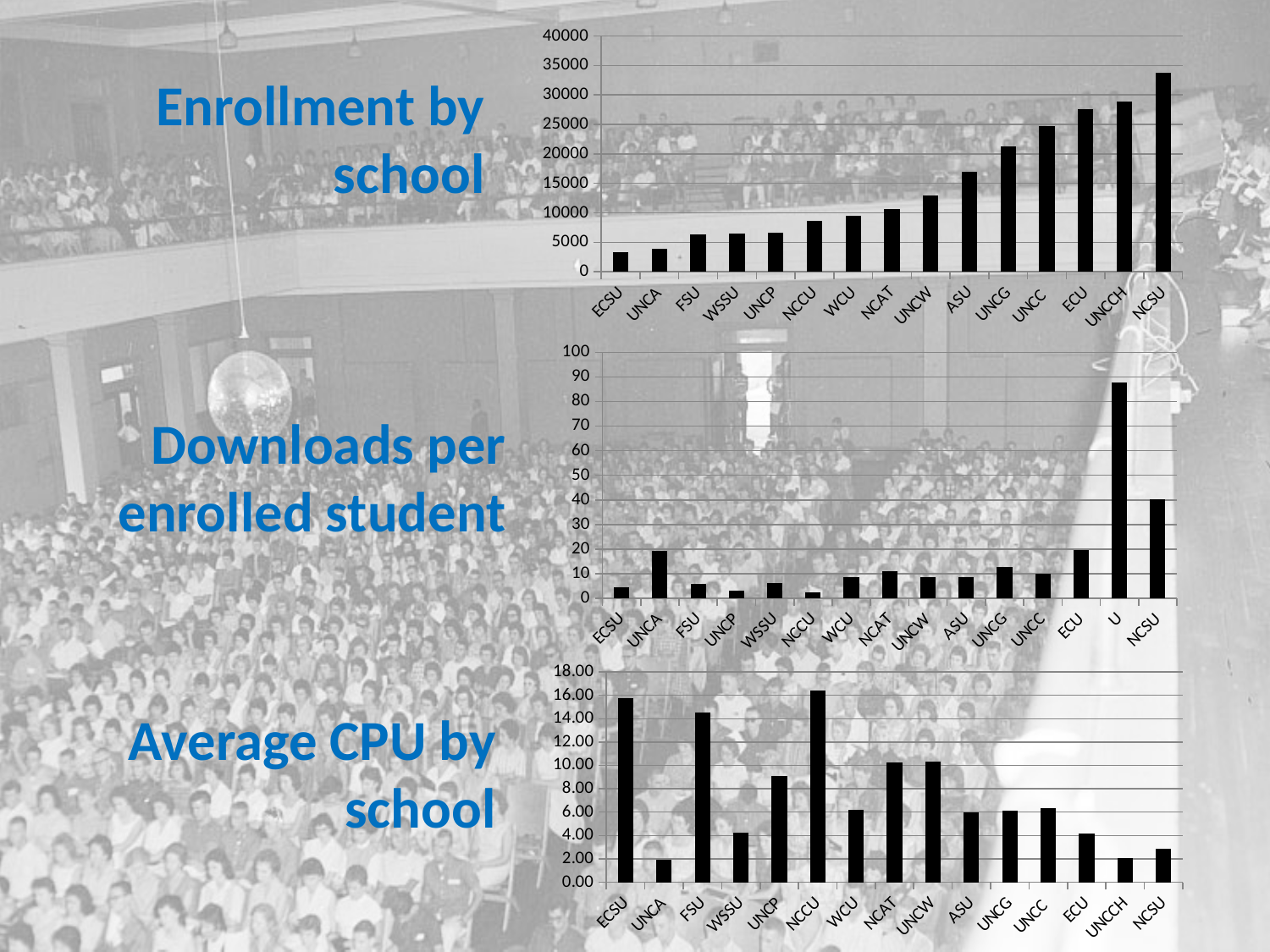
On the "Average CPU by school" chart, is the value for UNCA greater or less than 4.00? less On the "Enrollment by school" chart, is the value for NCSU greater or less than 30000? greater On the "Enrollment by school" chart, which school has the highest enrollment? NCSU On the "Downloads per enrolled student" chart, which has the larger value, UNCA or FSU? UNCA On the "Downloads per enrolled student" chart, which school has the highest value? U On the "Enrollment by school" chart, which school has the lowest enrollment? ECSU On the "Enrollment by school" chart, which has the larger value, ECU or UNCG? ECU How many schools are shown on the "Enrollment by school" chart? 15 On the "Average CPU by school" chart, which school has the highest value? NCCU What kind of chart is the "Enrollment by school" chart? bar chart On the "Enrollment by school" chart, do the values rise or fall from left to right along the x axis? rise On the "Downloads per enrolled student" chart, is the value for U greater or less than 80? greater